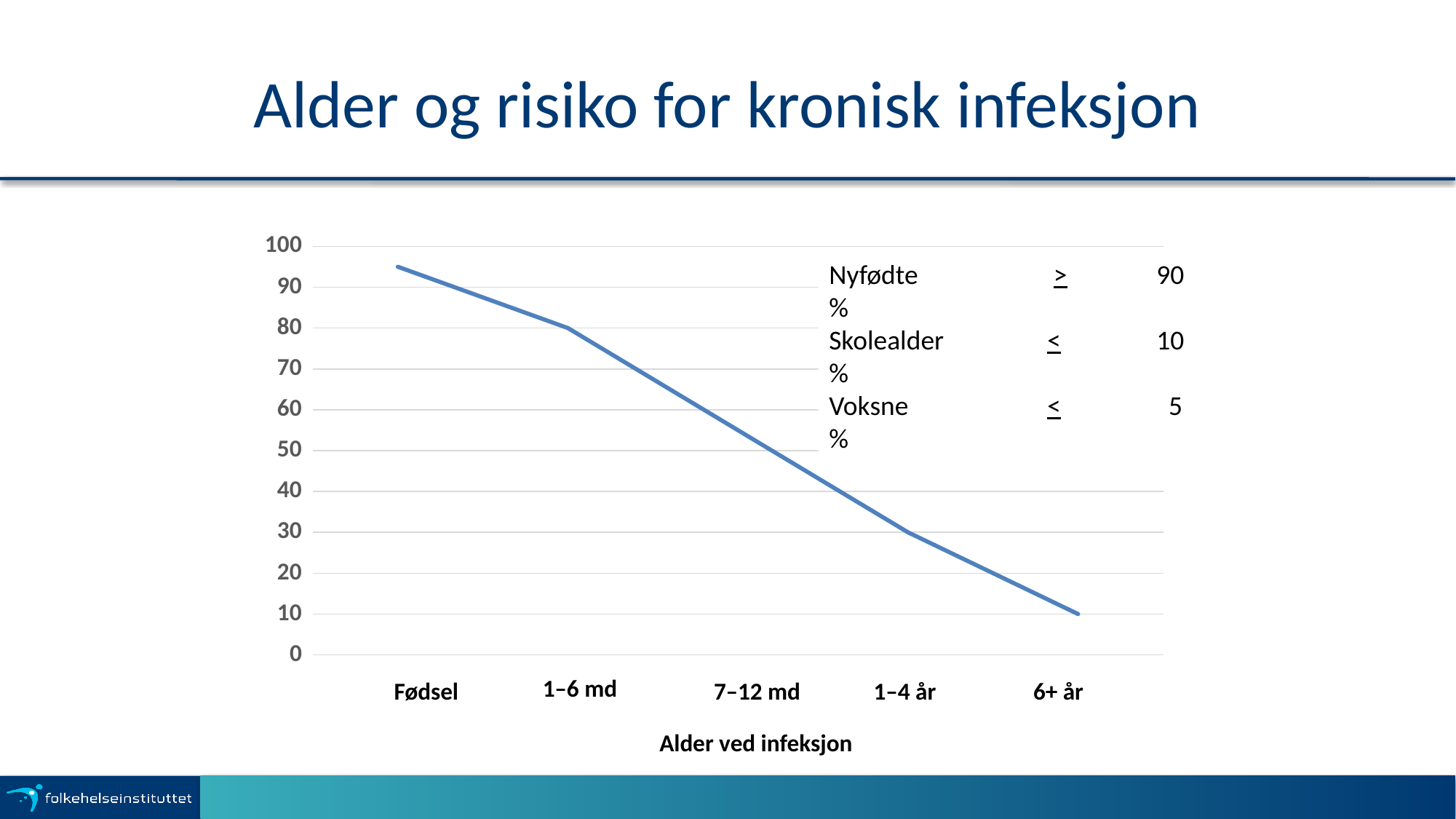
What is the x-axis title of the chart? Alder ved infeksjon Is the value for Fødsel greater or less than 90? greater How many age categories are shown on the x axis of the chart? 5 What kind of chart is shown on the slide? line chart Is the value for 7–12 md greater or less than 50? greater Is the value for 7–12 md greater or less than 60? less Which age category has the highest value on the chart? Fødsel Which age category has the lowest value on the chart? 6+ år What is the value for 6+ år? 10 What is the value for 1–6 md? 80 Which has a larger value, 1–6 md or 1–4 år? 1–6 md Do the values rise or fall along the x axis from Fødsel to 6+ år? fall